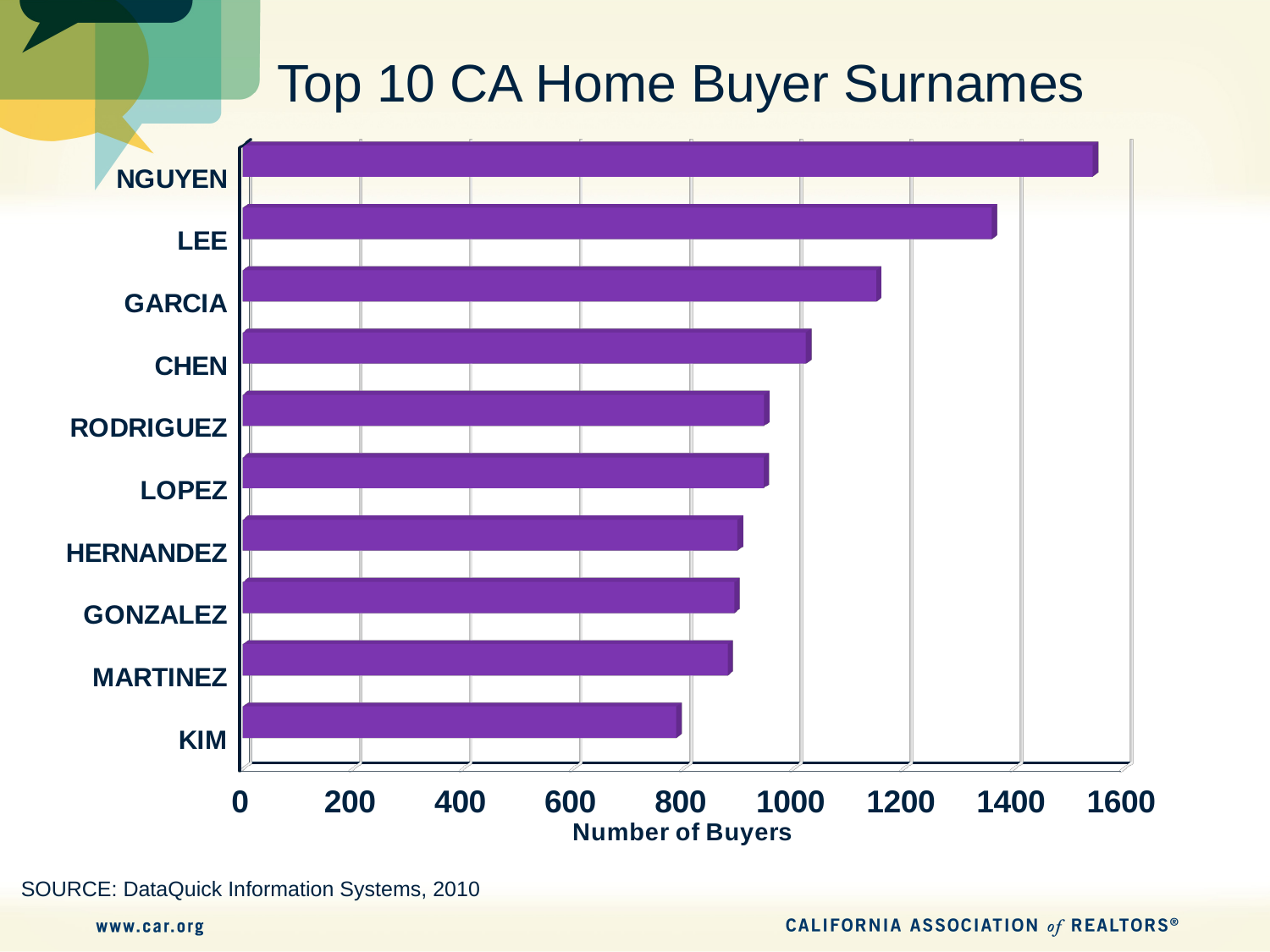
Which has more buyers, CHEN or KIM? CHEN How many surnames are plotted in the chart? 10 Is the value for GARCIA greater or less than 1000? greater Is the value for KIM greater or less than 1000? less Which surname has the lowest number of buyers? KIM Which has more buyers, LEE or GARCIA? LEE What is the label of the horizontal axis? Number of Buyers Is the value for LEE greater or less than 1200? greater Which surname has the highest number of buyers? NGUYEN What kind of chart is shown on the slide? bar chart